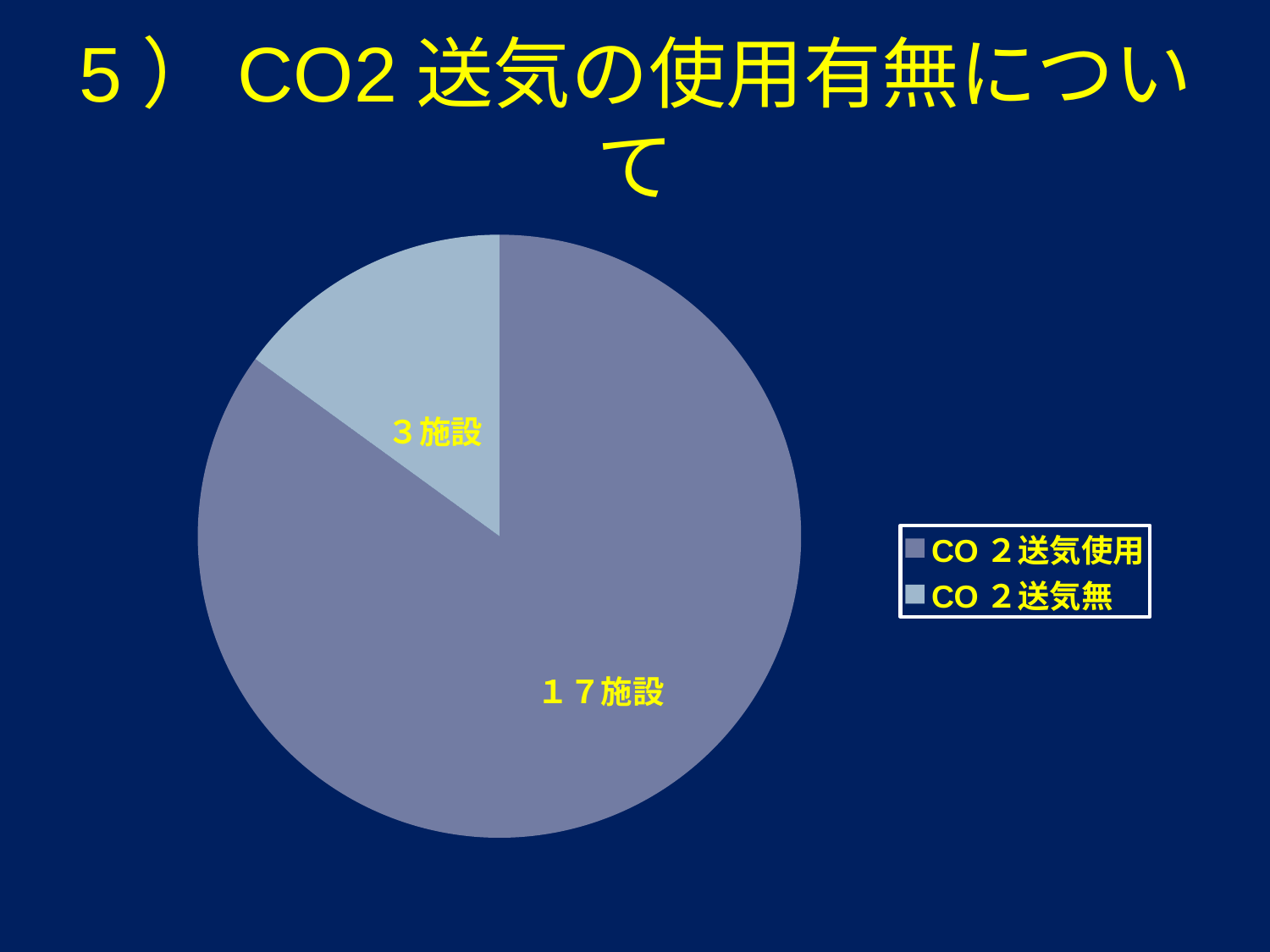
What kind of chart is shown on the slide? pie chart What share of the pie does CO２送気使用 represent? 85% How many entries does the legend list? 2 What is the title of the slide containing the pie chart? ５） CO2送気の使用有無について What is the value shown for CO２送気無? ３施設 How many slices does the pie chart have? 2 Which category has the smallest slice of the pie? CO２送気無 Which is larger, the number of facilities for CO２送気使用 or for CO２送気無? CO２送気使用 What is the difference in the number of facilities between CO２送気使用 and CO２送気無? １４施設 What is the total number of facilities represented in the pie chart? ２０施設 Which category has the largest slice of the pie? CO２送気使用 What is the value shown for CO２送気使用? １７施設